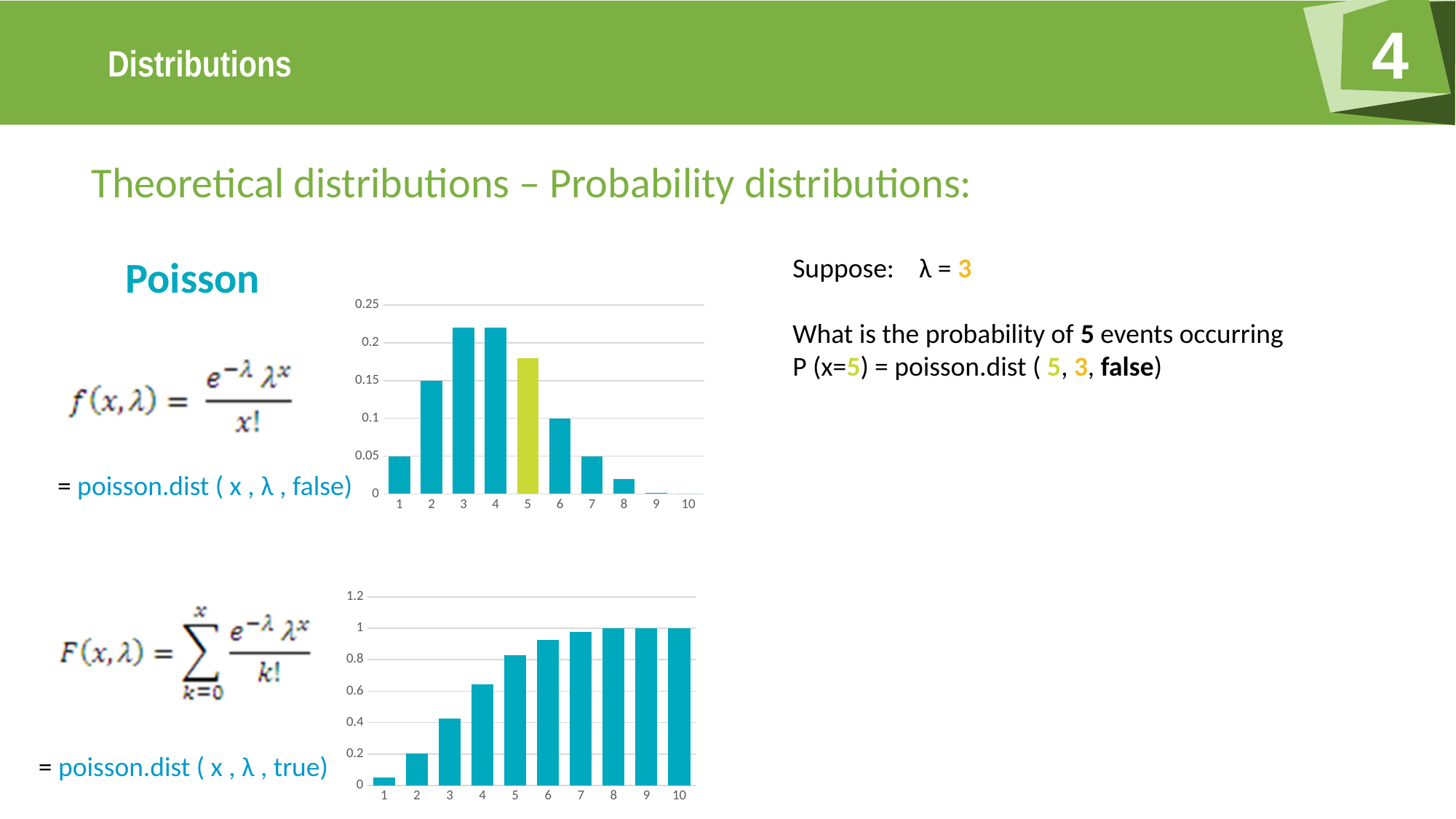
What kind of chart is the top chart on the slide? bar chart In the top chart, what is the value for category 6? 0.1 In the top chart, is the value for category 8 greater or less than 0.05? less In the top chart, which category's bar is coloured differently (yellow-green) from the others? 5 In the bottom chart, do the values rise or fall as the x axis goes from 1 to 10? rise In the top chart, what is the value for category 2? 0.15 How many categories are shown on the x axis of the top chart? 10 In the top chart, which is larger, the value for category 2 or the value for category 6? category 2 In the top chart, what is the difference between the values for category 2 and category 6? 0.05 In the top chart, is the value for category 5 greater or less than 0.15? greater How many categories are shown on the x axis of the bottom chart? 10 In the bottom chart, which category has the lowest value? 1